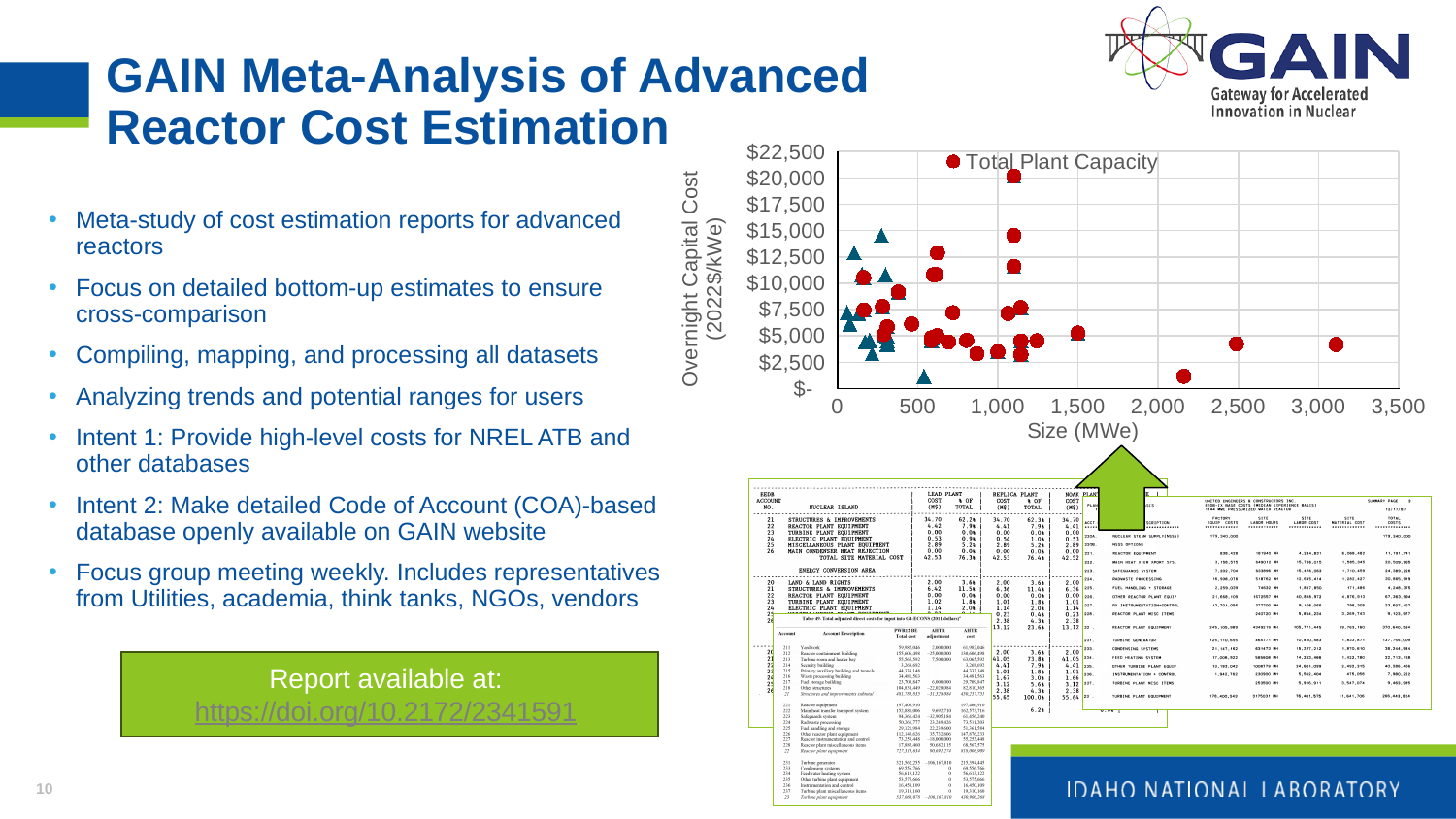
Is the overnight capital cost of the red circle plotted at roughly 2,500 MWe greater or less than $2,500? greater Is the overnight capital cost of the lowest teal triangle in the scatter chart greater or less than $2,500? less What series name is listed in the legend of the scatter chart? Total Plant Capacity Which has the higher overnight capital cost: the red circle at roughly 2,100 MWe or the red circle at roughly 3,000 MWe? The red circle at roughly 3,000 MWe Do the overnight capital costs of the red circles generally rise or fall as plant size increases along the x axis? fall Is the overnight capital cost of the highest teal triangle in the scatter chart greater or less than $12,500? greater What kind of chart is shown on the slide? Scatter chart How many series does the legend of the scatter chart list? 1 What is the title of the vertical axis of the scatter chart? Overnight Capital Cost (2022$/kWe)